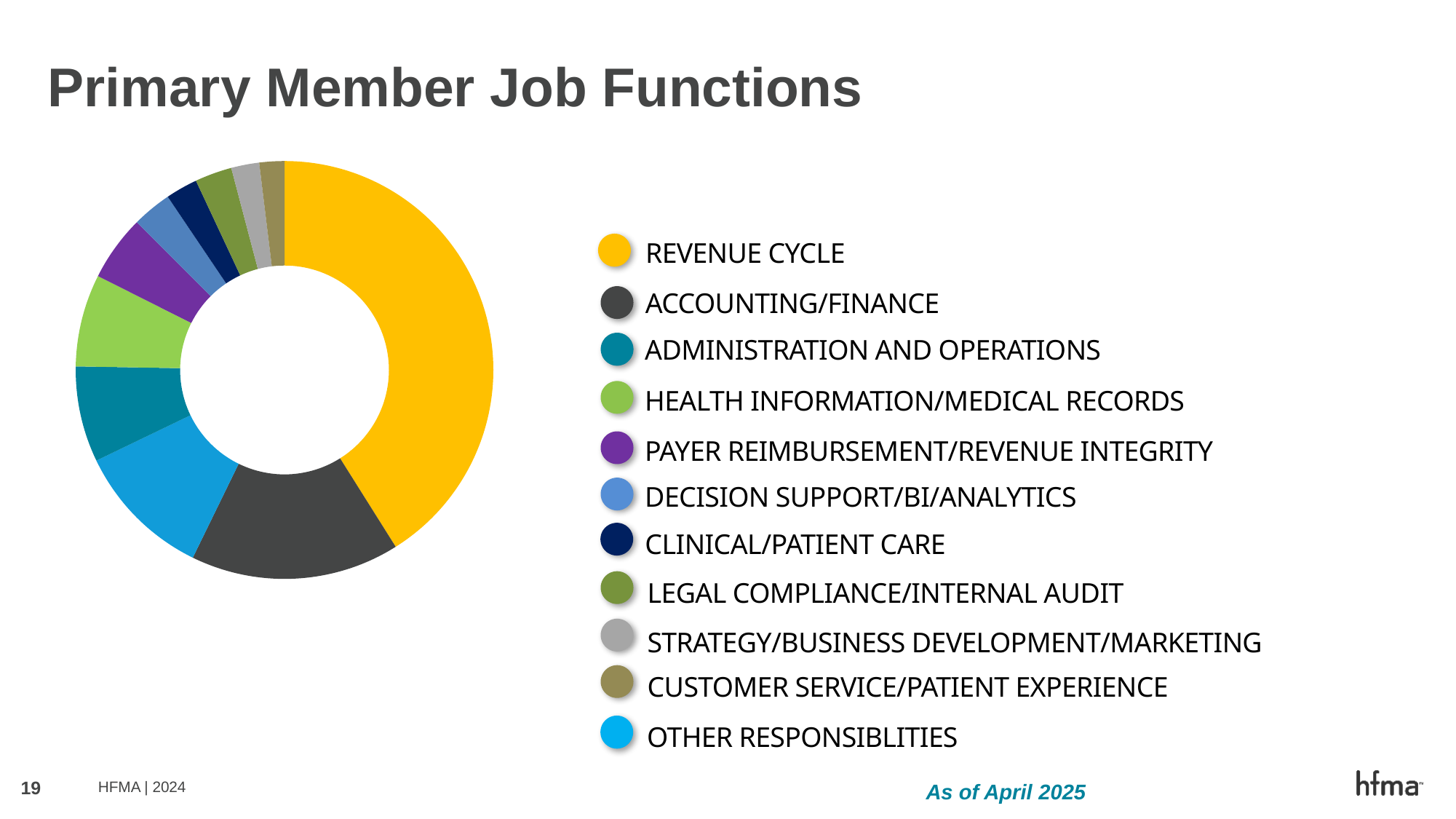
Which slice is larger, Administration and Operations or Decision Support/BI/Analytics? Administration and Operations Which slice is larger, Other Responsiblities or Clinical/Patient Care? Other Responsiblities What colour represents Revenue Cycle in the chart? Yellow Which slice is larger, Revenue Cycle or Accounting/Finance? Revenue Cycle Which job function has the largest slice of the chart? Revenue Cycle Is the Revenue Cycle slice greater or less than half of the chart? less How many job function categories does the legend list? 11 What kind of chart is shown on the slide? Pie chart (donut) What is the title of the slide's chart? Primary Member Job Functions